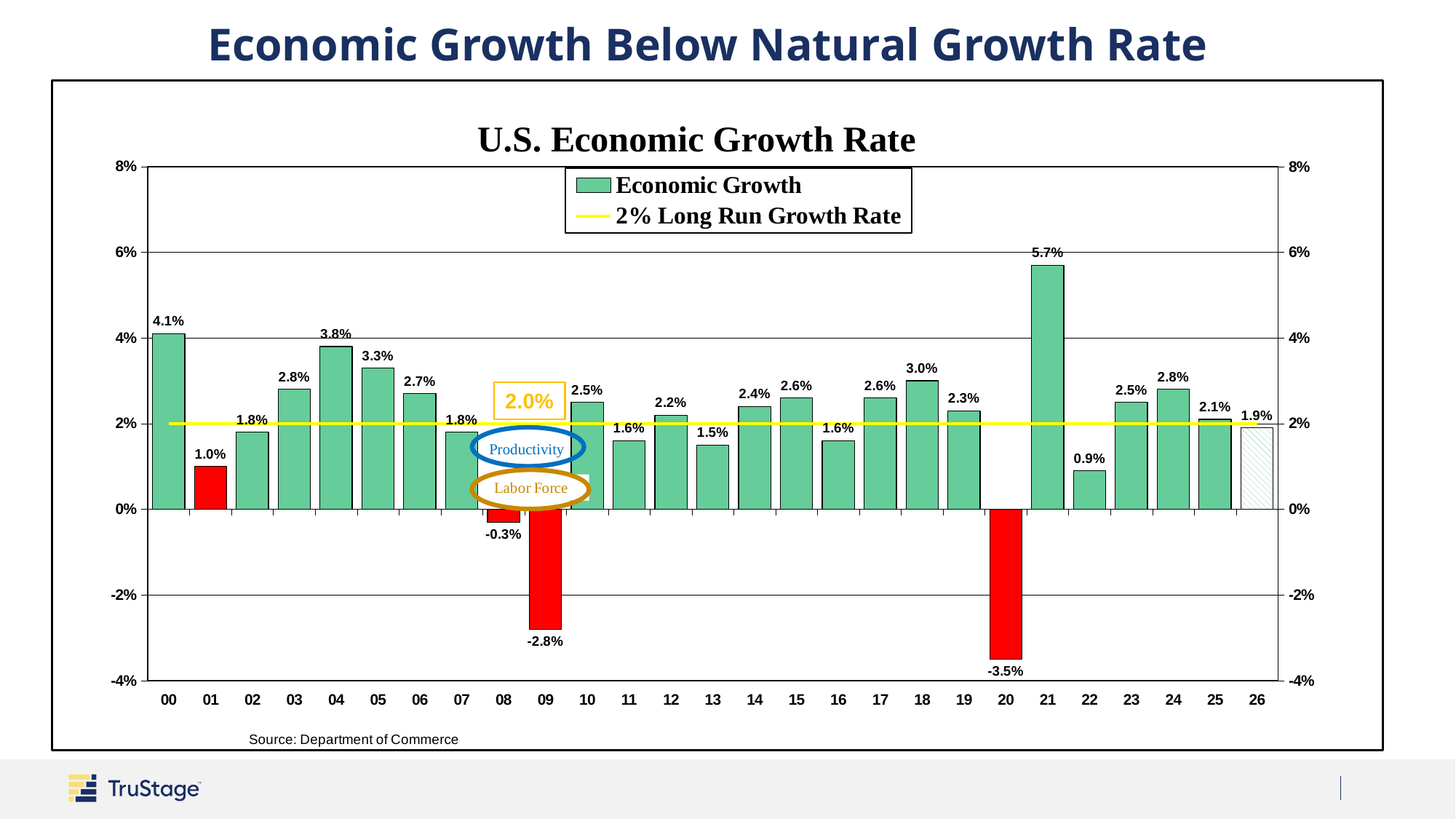
What is the economic growth rate shown for 21? 5.7% What is the economic growth rate shown for 09? -2.8% How many years are shown on the x axis? 27 Which year has a higher economic growth rate, 04 or 18? 04 What kind of chart is used to show the economic growth rate? bar chart Which year has the highest economic growth rate? 21 What is the title of the chart? U.S. Economic Growth Rate Which year has the lowest economic growth rate? 20 What is the economic growth rate shown for 26? 1.9% What is the difference between the economic growth rate in 00 and in 01? 3.1% How many series does the legend list? 2 Is the economic growth rate for 22 greater or less than 2%? less